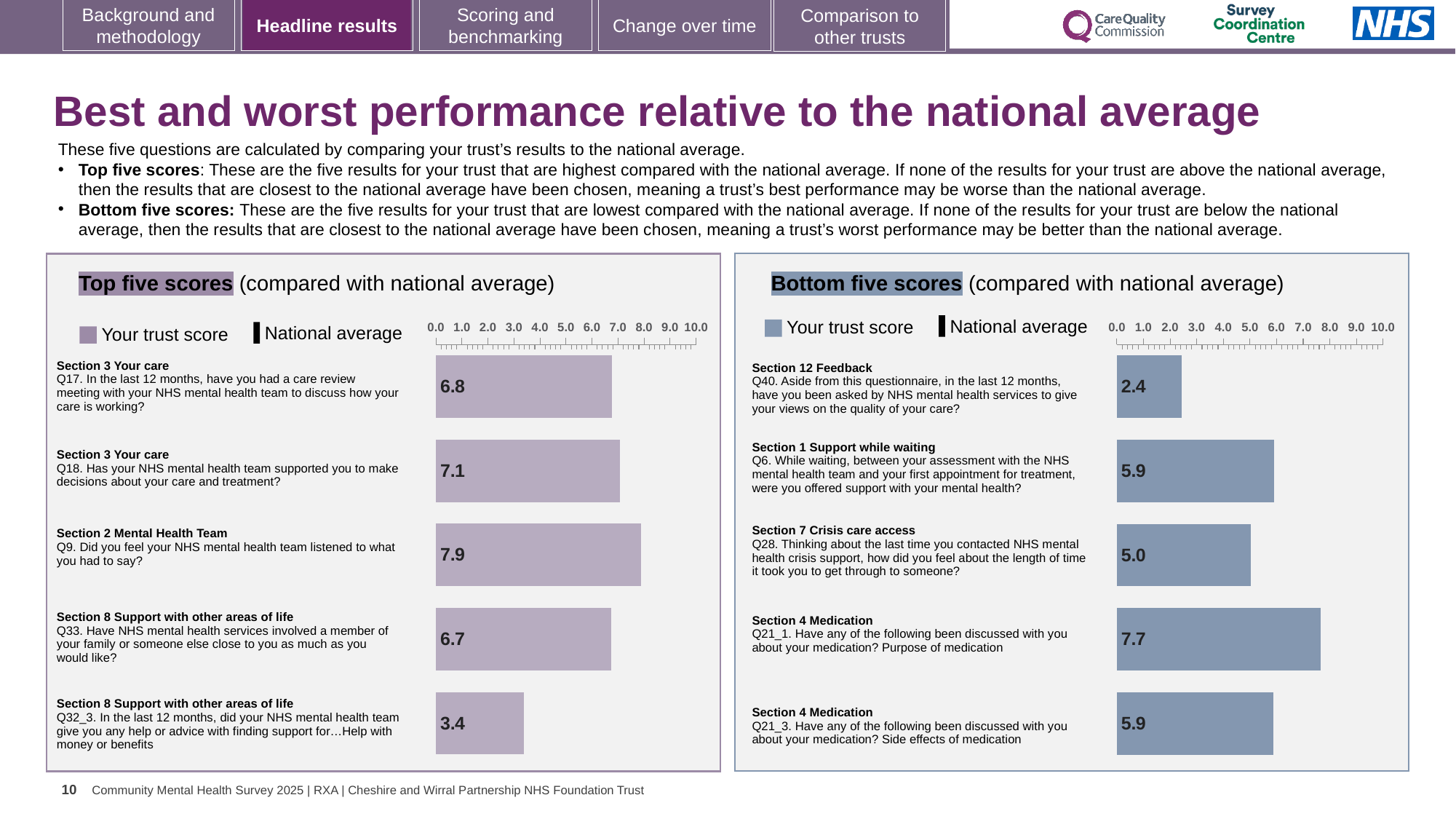
In the Top five scores chart, which question has the highest trust score? Q9 In the Top five scores chart, which question has the lowest trust score? Q32_3 In the Top five scores chart, what is the trust score for Q32_3 (help with finding support for money or benefits)? 3.4 What kind of chart is the Bottom five scores chart? Bar chart In the Top five scores chart, what is the difference between the trust scores for Q18 and Q17? 0.3 In the Bottom five scores chart, what is the difference between the trust scores for Q21_1 and Q21_3? 1.8 In the Bottom five scores chart, what is the trust score for Q40 (have you been asked by NHS mental health services to give your views on the quality of your care?)? 2.4 In the Bottom five scores chart, which question has the highest trust score? Q21_1 How many bars are plotted in the Top five scores chart? 5 In the Bottom five scores chart, which question has the lowest trust score? Q40 In the Top five scores chart, what is the trust score for Q9 (Did you feel your NHS mental health team listened to what you had to say?)? 7.9 In the Bottom five scores chart, which has the larger trust score, Q6 or Q28? Q6